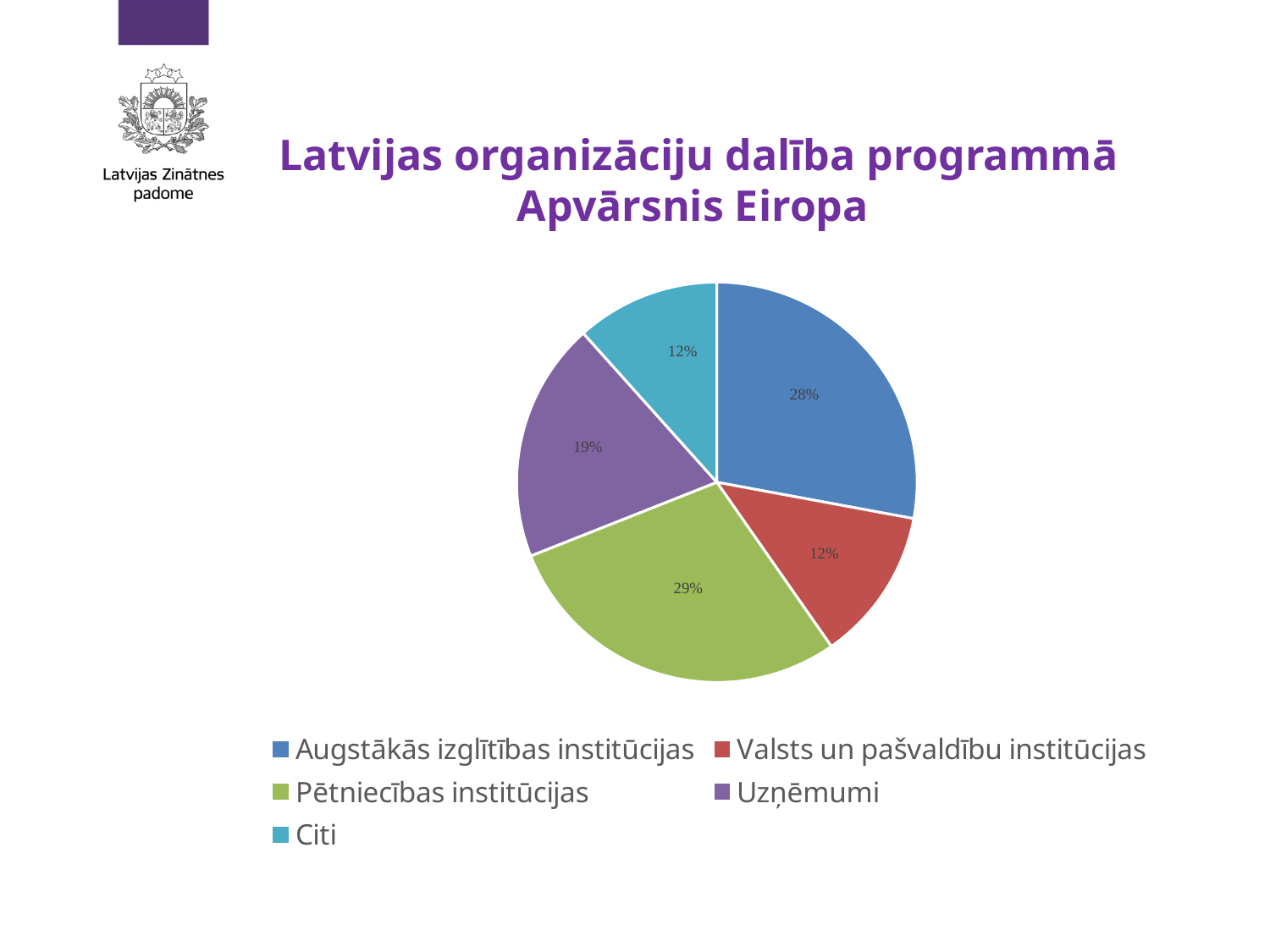
What share of the pie does Uzņēmumi have? 19% What share of the pie does Pētniecības institūcijas have? 29% What share of the pie does Citi have? 12% Which is larger, the share of Augstākās izglītības institūcijas or the share of Uzņēmumi? Augstākās izglītības institūcijas What kind of chart is shown on the slide? pie chart What is the difference between the shares of Pētniecības institūcijas and Uzņēmumi? 10% Which category has the largest slice of the pie? Pētniecības institūcijas Which category is shown in green in the pie chart? Pētniecības institūcijas What is the title of the chart? Latvijas organizāciju dalība programmā Apvārsnis Eiropa How many slices does the pie chart have? 5